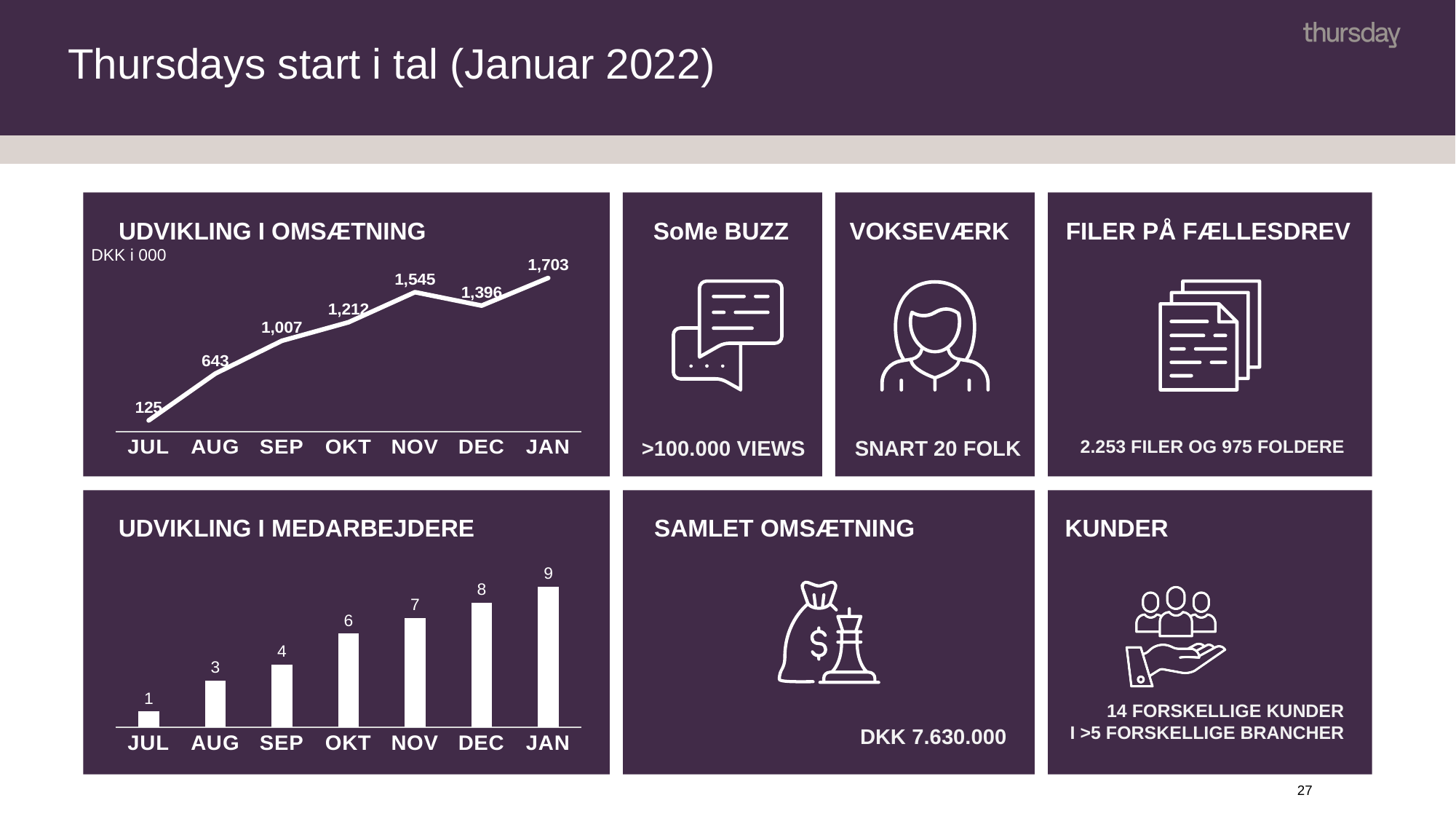
What kind of chart is 'UDVIKLING I OMSÆTNING'? Line chart In the 'UDVIKLING I OMSÆTNING' chart, which is larger, NOV or DEC? NOV In the 'UDVIKLING I OMSÆTNING' chart, which month has the highest value? JAN How many months are shown in the 'UDVIKLING I MEDARBEJDERE' chart? 7 In the 'UDVIKLING I MEDARBEJDERE' chart, which month has the lowest value? JUL In the 'UDVIKLING I OMSÆTNING' chart, what unit is stated below the title? DKK i 000 In the 'UDVIKLING I MEDARBEJDERE' chart, what is the value for OKT? 6 In the 'UDVIKLING I MEDARBEJDERE' chart, what is the difference between JAN and JUL? 8 In the 'UDVIKLING I OMSÆTNING' chart, what is the value for NOV? 1,545 In the 'UDVIKLING I OMSÆTNING' chart, what is the difference between JAN and DEC? 307 In the 'UDVIKLING I MEDARBEJDERE' chart, do the values rise or fall from JUL to JAN? Rise In the 'UDVIKLING I OMSÆTNING' chart, what is the value for JUL? 125